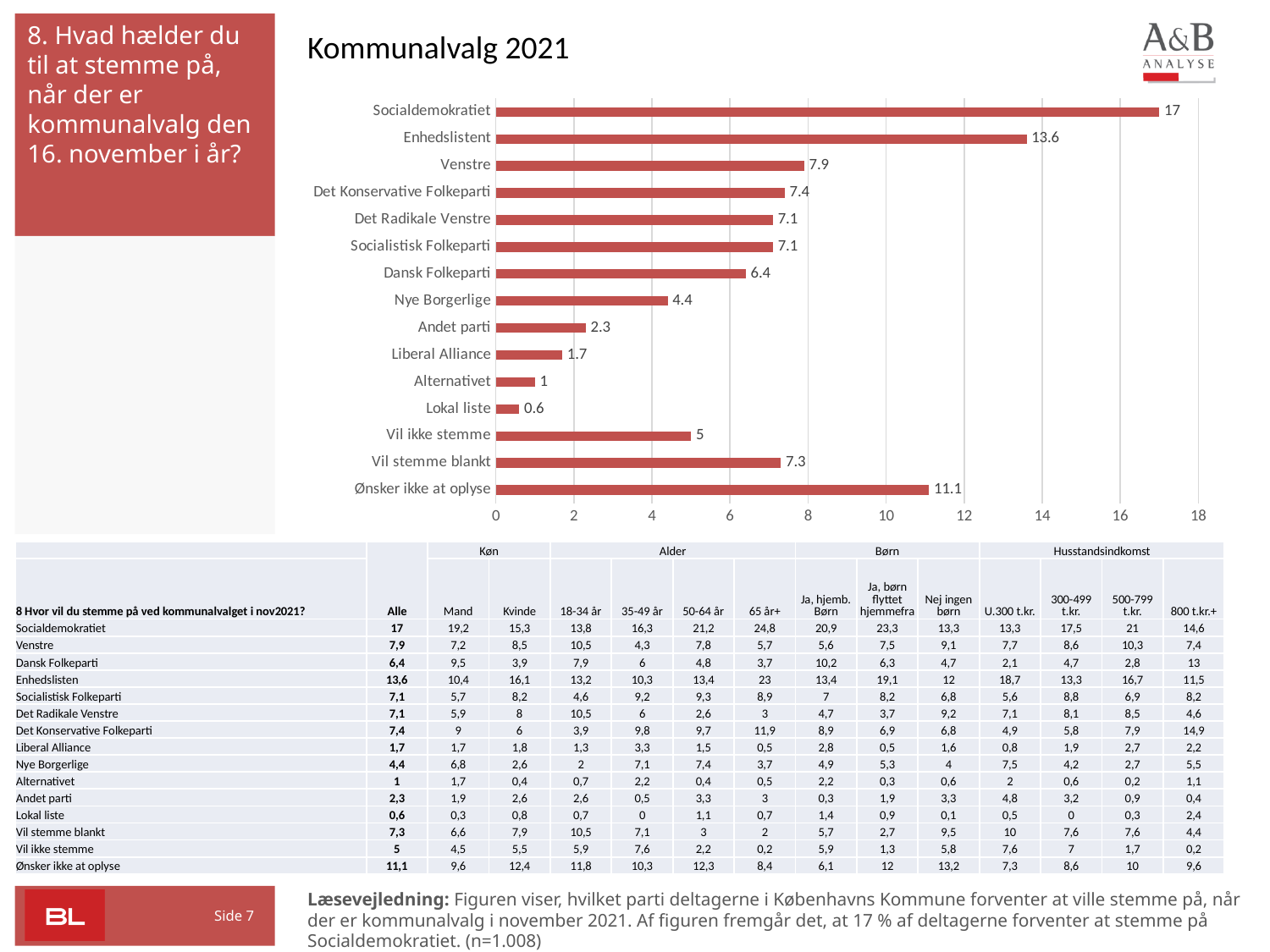
Which category has the lowest value in the chart? Lokal liste What is the value for Socialdemokratiet in the chart? 17 What kind of chart is shown on the slide? Bar chart Which category has the highest value in the chart? Socialdemokratiet What is the value for Ønsker ikke at oplyse in the chart? 11.1 What is the value for Enhedslisten in the chart? 13.6 How many categories are shown in the chart? 15 Which has a larger value, Venstre or Dansk Folkeparti? Venstre What is the value for Nye Borgerlige in the chart? 4.4 What is the title of the chart? Kommunalvalg 2021 What is the difference between the values for Socialdemokratiet and Enhedslisten? 3.4 Is the value for Ønsker ikke at oplyse greater or less than 10? greater